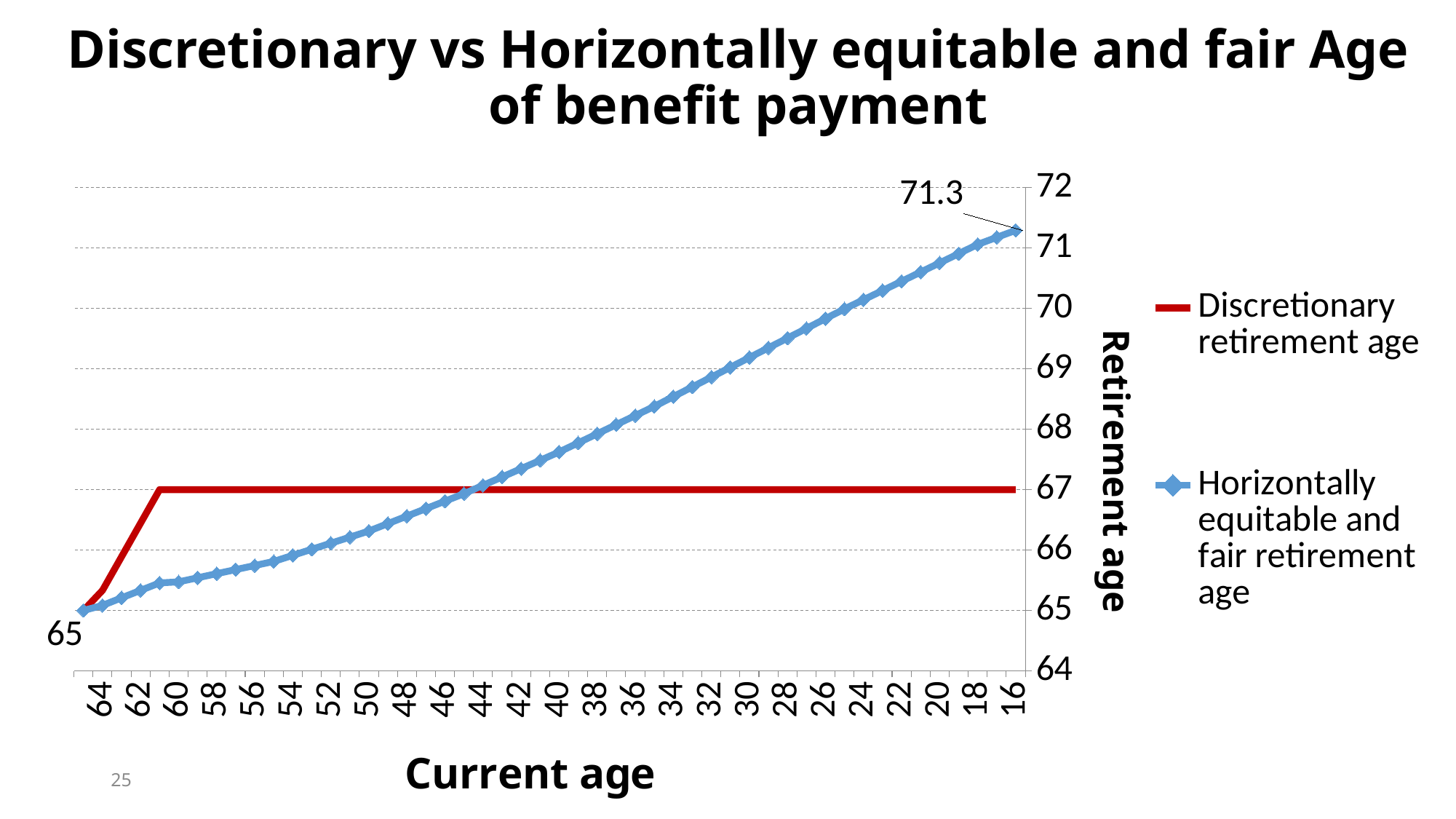
Is the horizontally equitable and fair retirement age at current age 20 greater or less than 70? greater What kind of chart is shown on the slide? line chart What is the horizontally equitable and fair retirement age for a current age of 16? 71.3 Is the horizontally equitable and fair retirement age at current age 50 greater or less than 67? less What is the discretionary retirement age for a current age of 40? 67 Moving left to right along the x axis, does the horizontally equitable and fair retirement age line rise or fall? rise How many series does the legend list? 2 At a current age of 30, which series shows the higher retirement age? Horizontally equitable and fair retirement age What retirement age is labelled at the left end of the lines, at current age 65? 65 What is the title of the vertical axis? Retirement age At a current age of 56, which series shows the higher retirement age? Discretionary retirement age What is the difference between the two labelled values on the chart, 71.3 and 65? 6.3